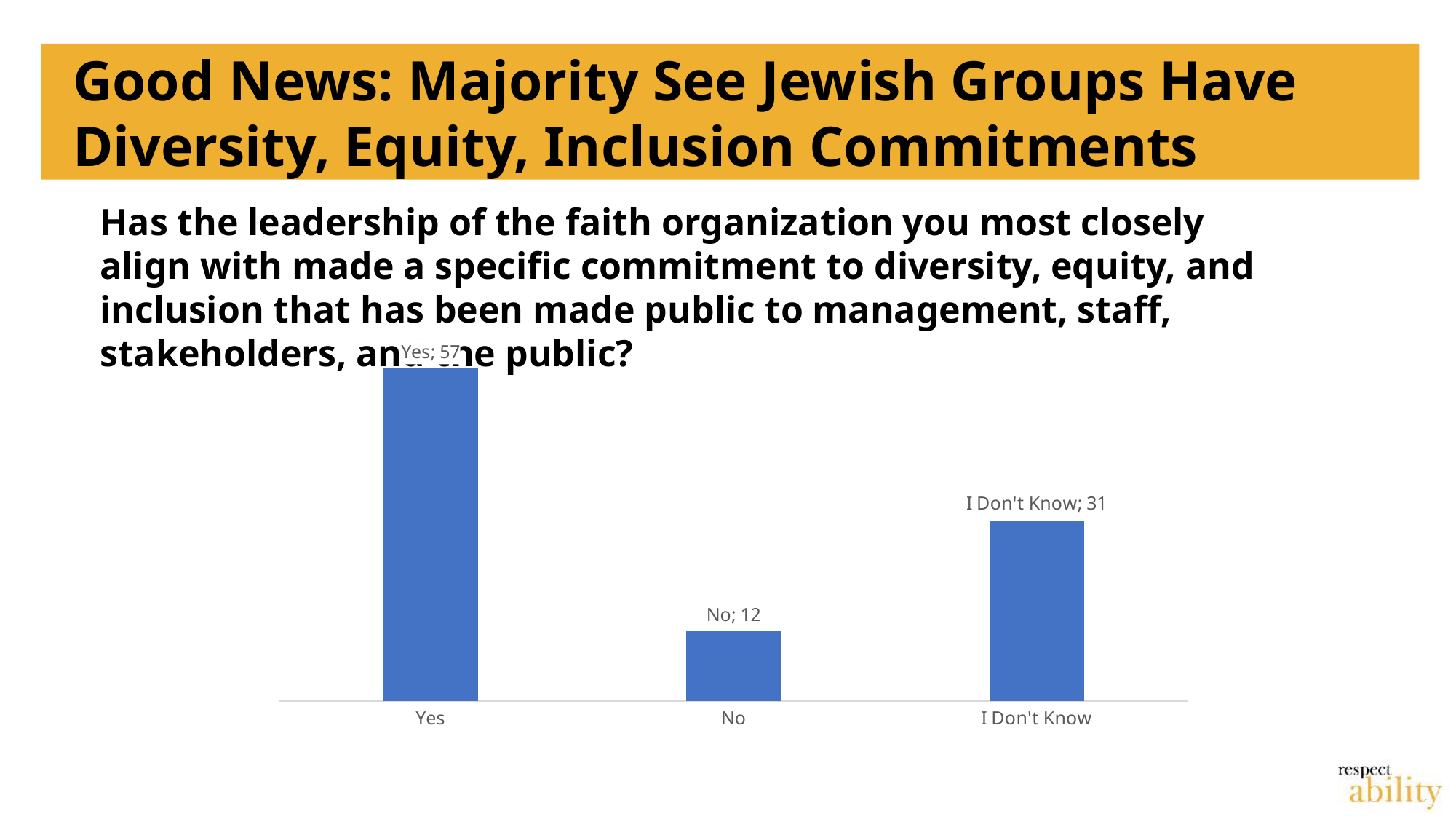
Which category has the lowest value? No What is the difference between the "I Don't Know" value and the "No" value? 19 What kind of chart is shown on the slide? Bar chart Which category has the highest value? Yes How many categories are shown on the chart? 3 What colour are the bars in the chart? Blue What is the total of the three bar values? 100 What is the difference between the "Yes" value and the "No" value? 45 What is the value for the "Yes" bar? 57 What is the value for the "No" bar? 12 Which is larger, the value for "I Don't Know" or the value for "No"? I Don't Know What is the value for the "I Don't Know" bar? 31